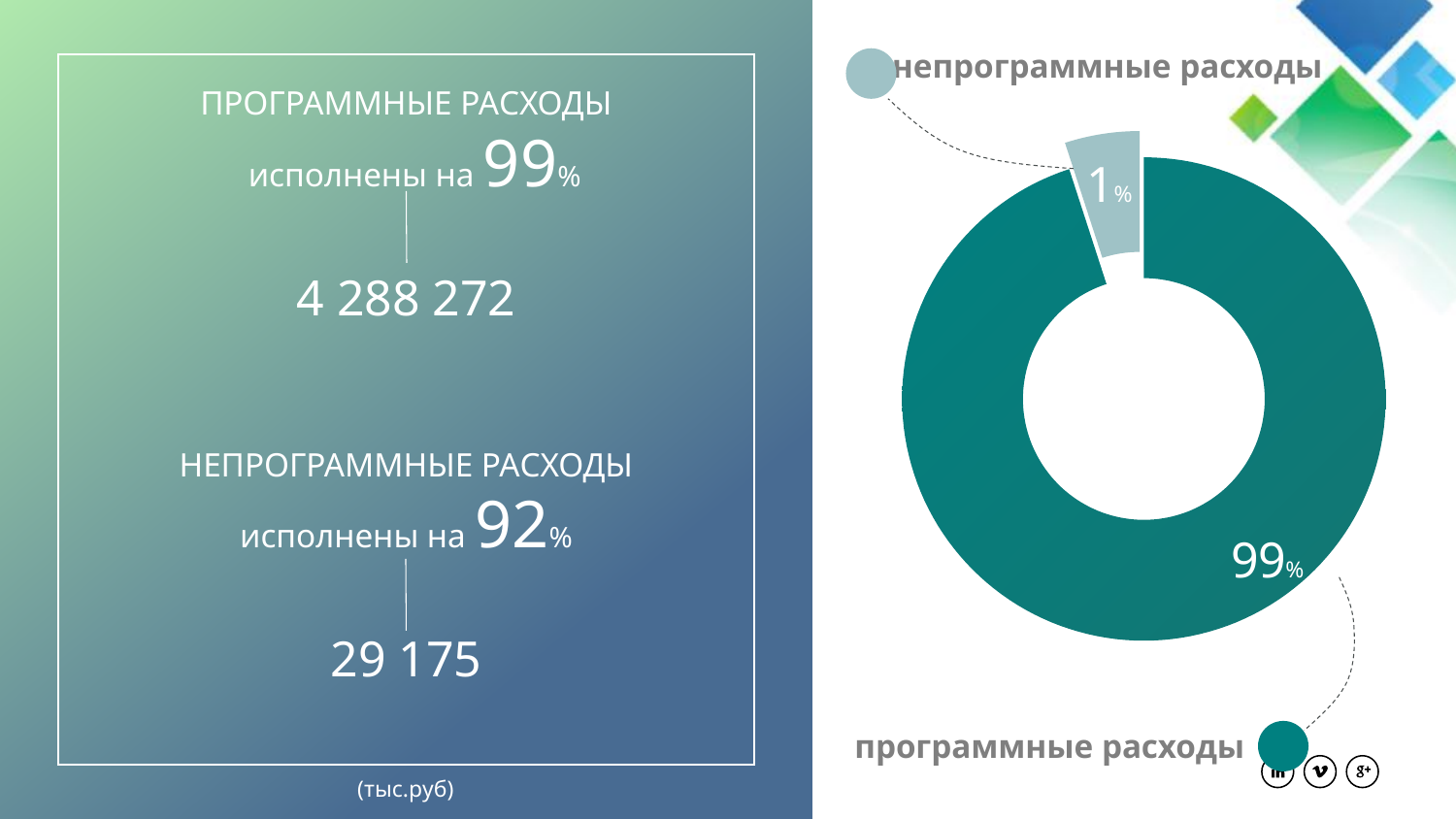
What share of the donut chart is labelled "программные расходы"? 99% Which category has the largest slice in the donut chart? программные расходы Which category label is connected to the light-blue marker at the top of the donut chart? непрограммные расходы Which slice is larger: "программные расходы" or "непрограммные расходы"? программные расходы What kind of chart is shown on the right side of the slide? Pie (donut) chart What is the value printed on the small light-blue slice of the donut chart? 1% What is the value printed on the large teal slice of the donut chart? 99% What colour is the slice for "программные расходы" in the donut chart? Teal (dark green) How many slices does the donut chart have? 2 What share of the donut chart is labelled "непрограммные расходы"? 1% What is the difference in percentage points between the "программные расходы" slice and the "непрограммные расходы" slice? 98 percentage points Which category has the smallest slice in the donut chart? непрограммные расходы